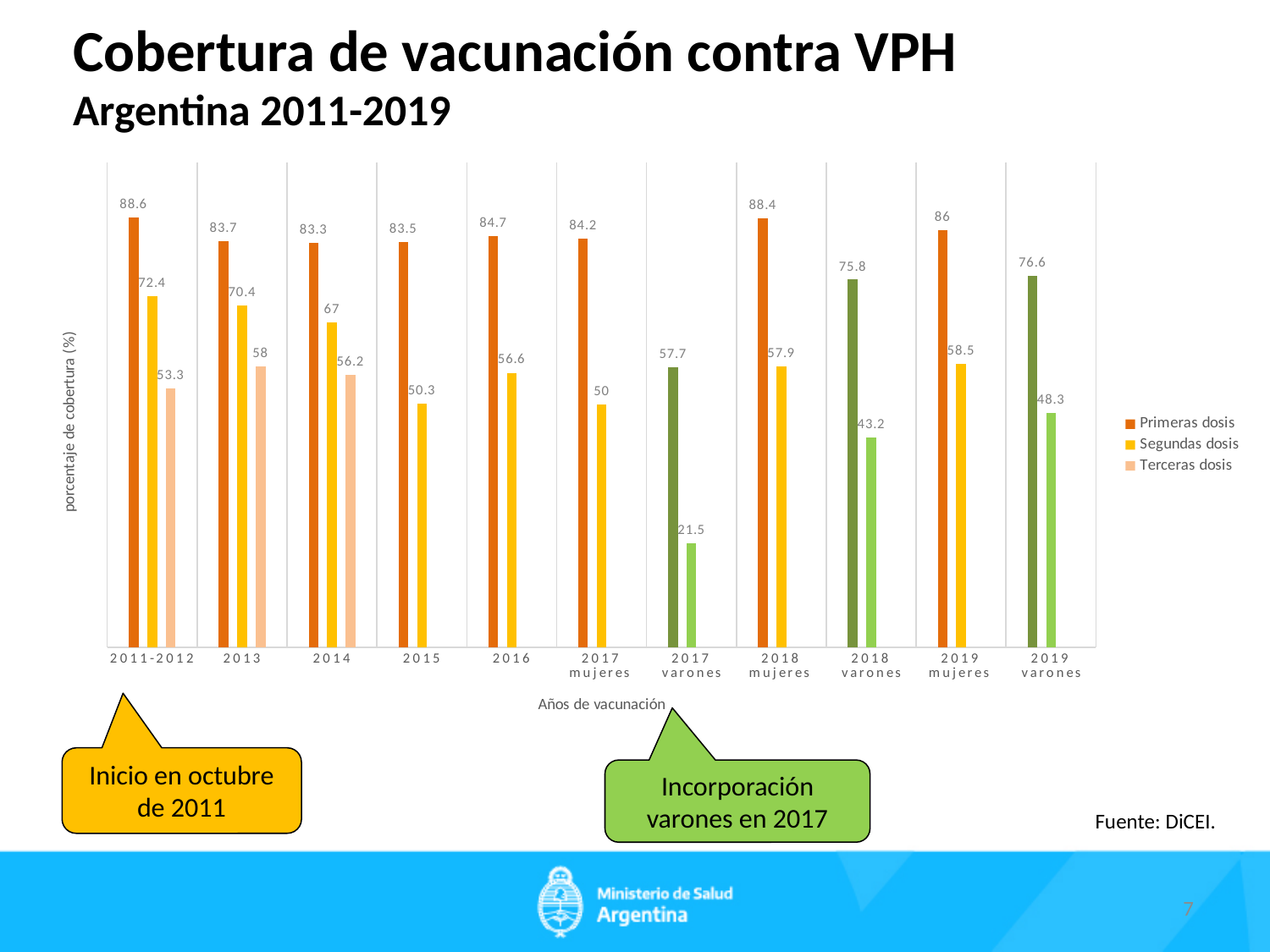
What kind of chart is shown on the slide? bar chart What is the label of the y axis? porcentaje de cobertura (%) Which is larger: the first bar for 2018 varones or the first bar for 2019 varones? 2019 varones What is the difference between Primeras dosis and Segundas dosis for 2018 mujeres? 30.5 Which category has the highest Primeras dosis value? 2011-2012 What is the value of the second bar for 2017 varones? 21.5 What is the value of Segundas dosis for 2016? 56.6 How many series does the legend list? 3 What is the value of Primeras dosis for 2011-2012? 88.6 Which category has the lowest Segundas dosis value among the orange/yellow series (2011-2012 to 2019 mujeres)? 2017 mujeres What is the value of Terceras dosis for 2014? 56.2 How many categories are shown on the x axis? 11